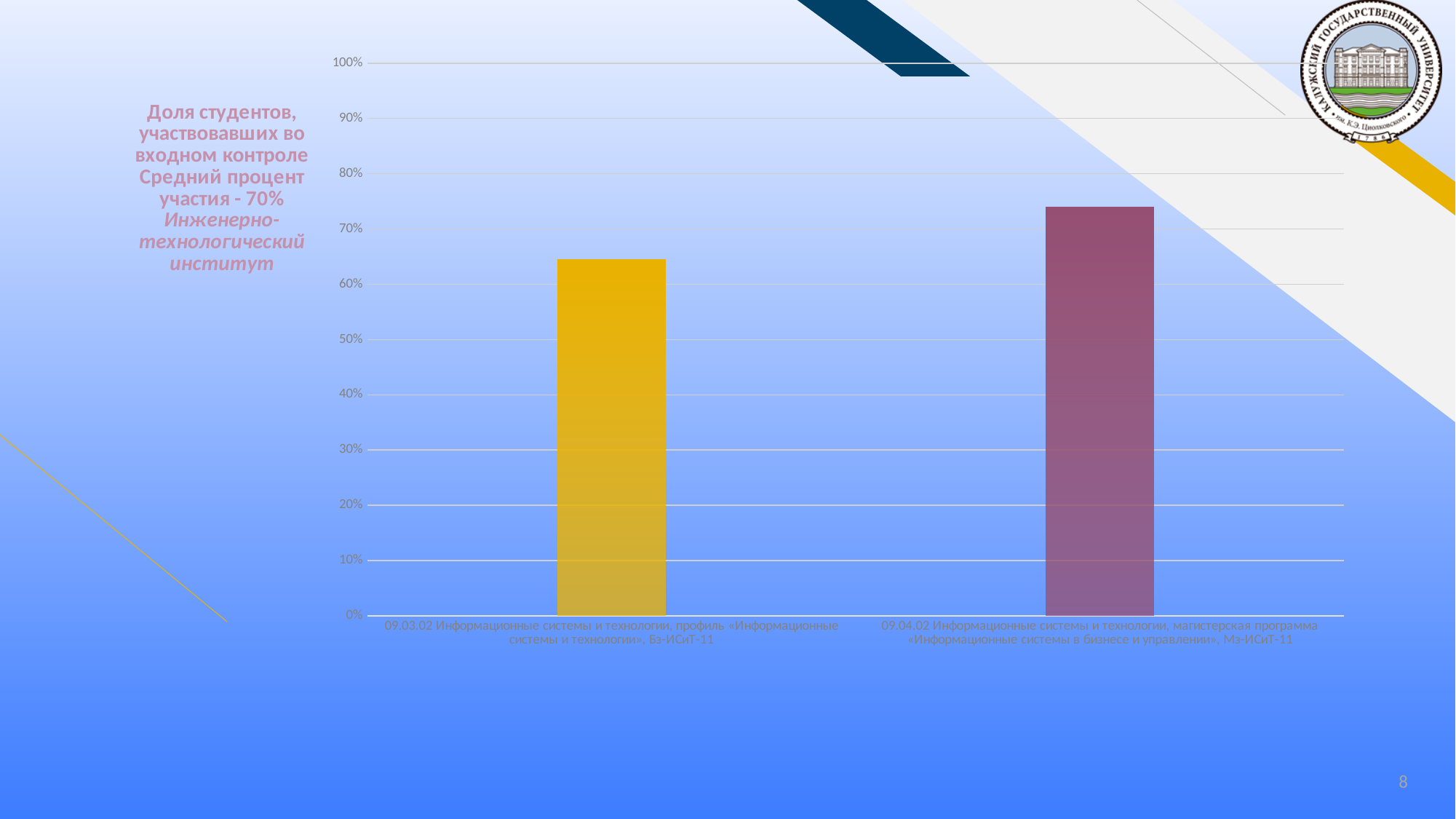
Which category has the lowest bar? 09.03.02 Информационные системы и технологии, профиль «Информационные системы и технологии», Бз-ИСиТ-11 Is the value for Бз-ИСиТ-11 greater or less than 60%? greater Which bar is taller: Бз-ИСиТ-11 or Мз-ИСиТ-11? Мз-ИСиТ-11 Is the value for Мз-ИСиТ-11 greater or less than 80%? less What kind of chart is shown on the slide? bar chart How many bars (categories) does the chart show? 2 Which category has the highest bar? 09.04.02 Информационные системы и технологии, магистерская программа «Информационные системы в бизнесе и управлении», Мз-ИСиТ-11 What is the highest value shown on the vertical axis? 100% Is the value for Бз-ИСиТ-11 greater or less than 70%? less What colour is the bar for Бз-ИСиТ-11? yellow